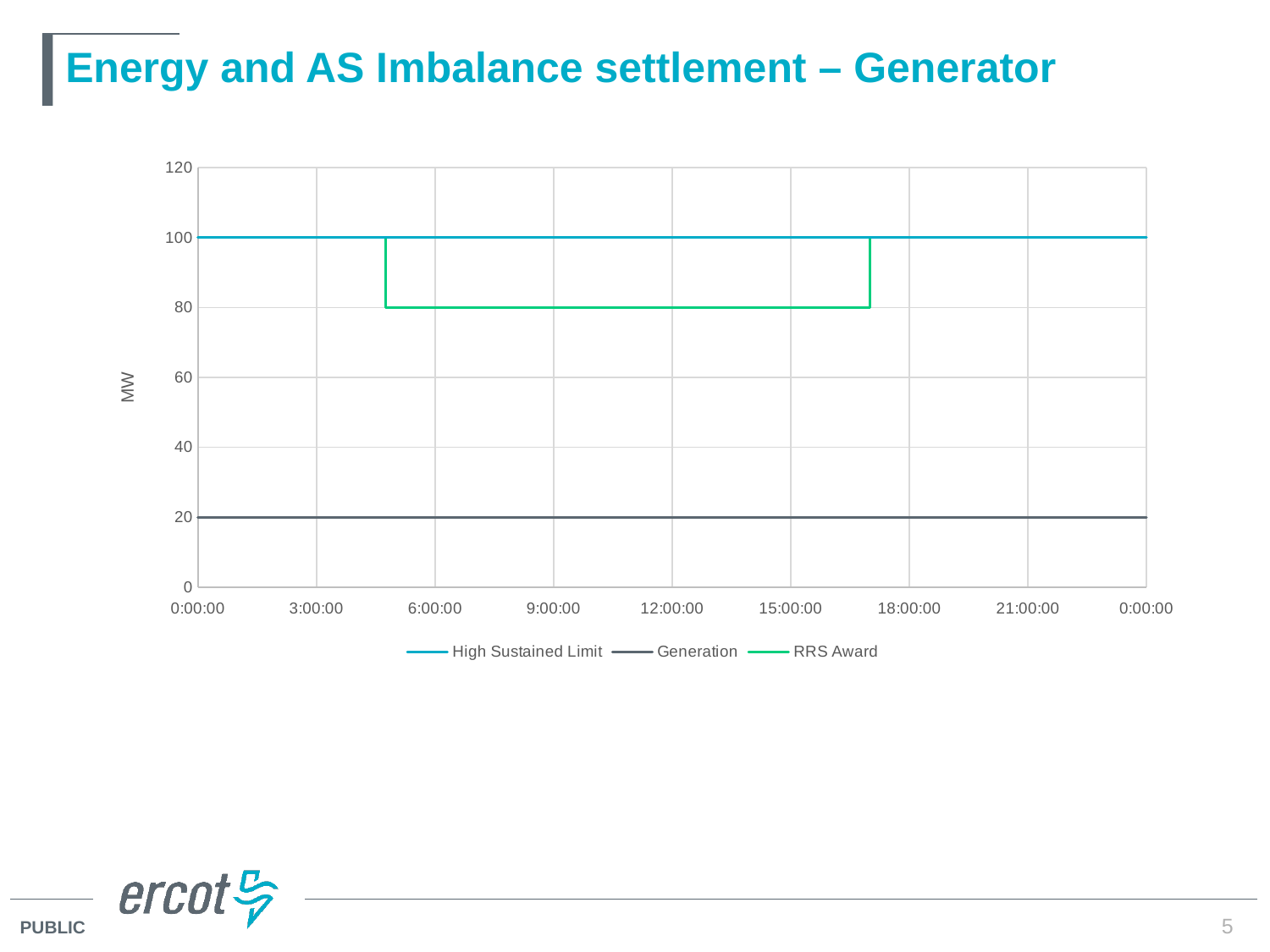
What is the label on the vertical axis? MW Which is larger at 9:00:00, the RRS Award or the Generation value? RRS Award Which series has the lowest value at 12:00:00? Generation Which series has the highest value at 12:00:00? High Sustained Limit What is the value of the RRS Award line at 12:00:00? 80 What is the value of the High Sustained Limit line at 12:00:00? 100 Is the Generation value at 15:00:00 greater or less than 40? less What is the difference between the High Sustained Limit and the RRS Award at 12:00:00? 20 What is the value of the Generation line at 9:00:00? 20 What kind of chart is shown on the slide? line chart How many series does the legend list? 3